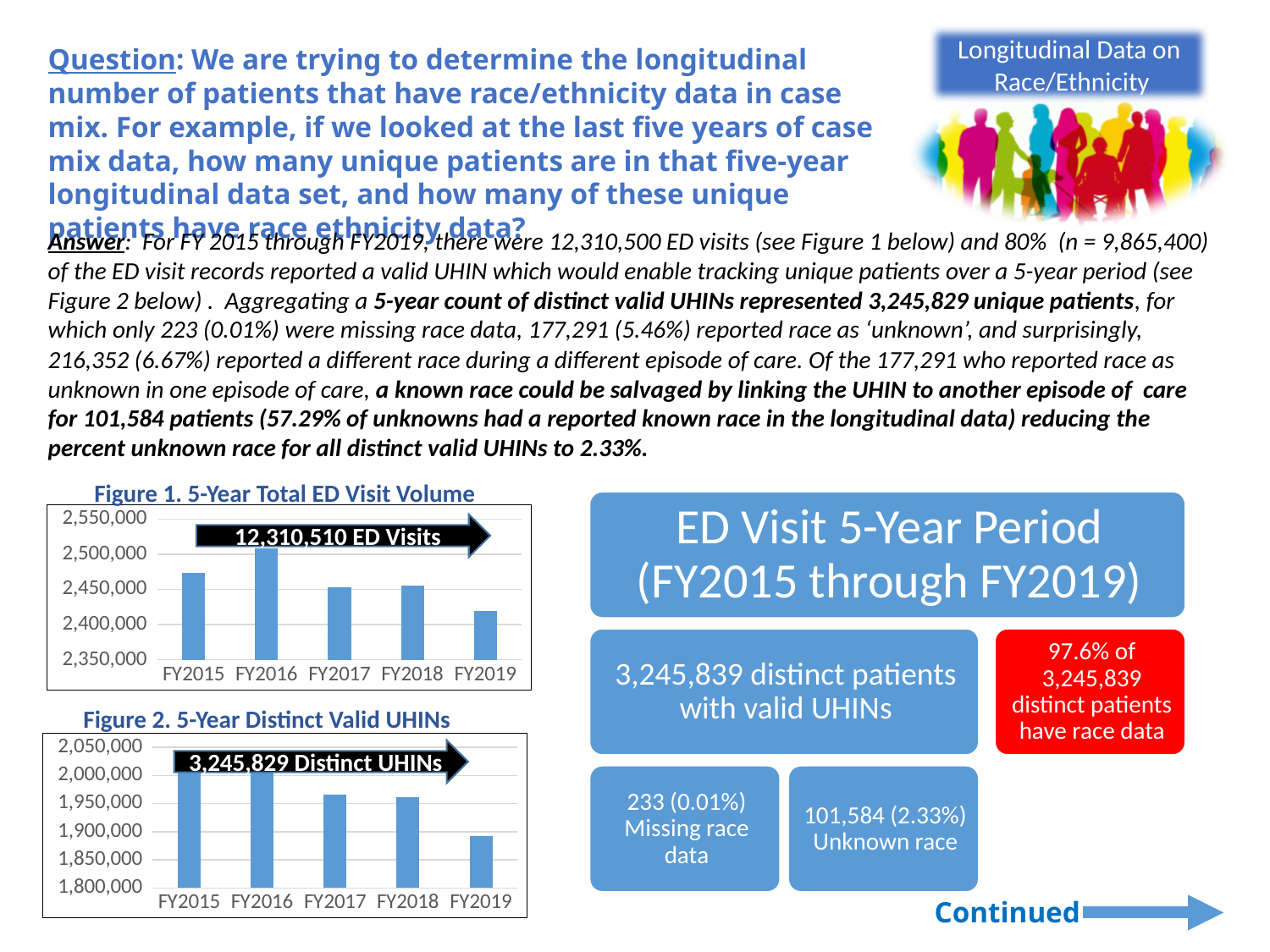
In Figure 1. 5-Year Total ED Visit Volume, which is larger, the value for FY2015 or the value for FY2019? FY2015 In Figure 2. 5-Year Distinct Valid UHINs, do the values generally rise or fall from FY2015 to FY2019? fall In Figure 2. 5-Year Distinct Valid UHINs, which fiscal year has the lowest value? FY2019 What kind of chart is Figure 1. 5-Year Total ED Visit Volume? bar chart In Figure 1. 5-Year Total ED Visit Volume, which fiscal year has the lowest ED visit volume? FY2019 What total is printed in the arrow annotation on Figure 1. 5-Year Total ED Visit Volume? 12,310,510 ED Visits In Figure 1. 5-Year Total ED Visit Volume, is the value for FY2015 greater or less than 2,450,000? greater In Figure 2. 5-Year Distinct Valid UHINs, is the value for FY2019 greater or less than 1,900,000? less How many fiscal years are shown on the x axis of Figure 1. 5-Year Total ED Visit Volume? 5 In Figure 2. 5-Year Distinct Valid UHINs, is the value for FY2015 greater or less than 2,000,000? greater In Figure 1. 5-Year Total ED Visit Volume, which fiscal year has the highest ED visit volume? FY2016